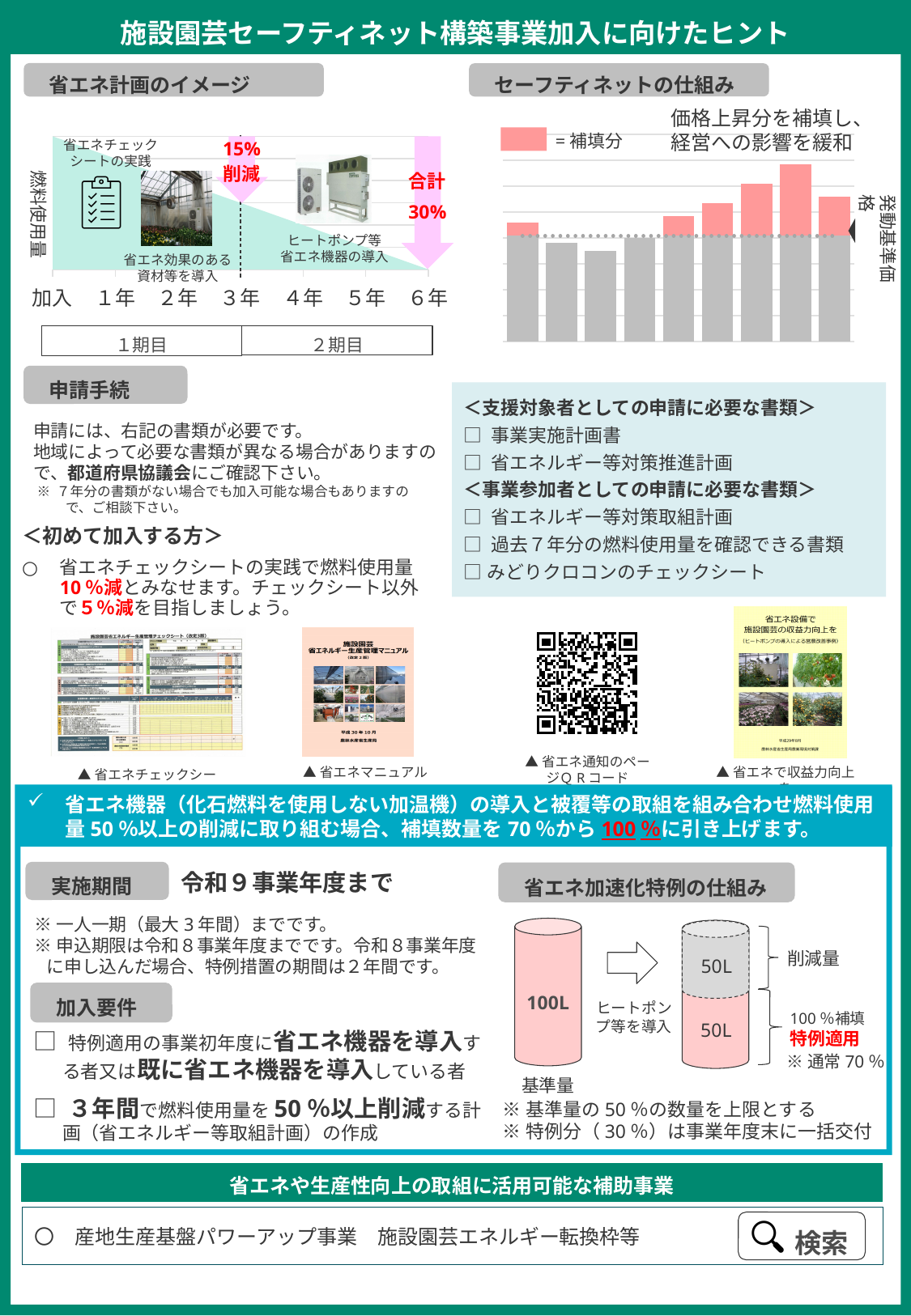
In the セーフティネットの仕組み chart, how many bars are plotted? 9 In the 省エネ計画のイメージ chart, what reduction percentage is marked at 3年? 15%削減 In the 省エネ加速化特例の仕組み diagram, what is the 基準量 shown on the left cylinder? 100L In the セーフティネットの仕組み chart, what does the pink colour represent according to the legend? 補填分 In the 省エネ計画のイメージ chart, how many tick labels are shown along the horizontal axis (from 加入 to 6年)? 7 In the 省エネ計画のイメージ chart, what total reduction is marked at 6年? 合計30% In the セーフティネットの仕組み chart, what is the label on the right-hand axis? 発動基準価格 In the セーフティネットの仕組み chart, how many bars have a pink (補填分) portion above the 発動基準価格 line? 6 In the 省エネ計画のイメージ chart, does fuel usage (燃料使用量) rise or fall from 加入 to 6年? fall In the 省エネ計画のイメージ chart, what is the label on the vertical axis? 燃料使用量 What kind of chart is shown under the heading セーフティネットの仕組み? bar chart In the 省エネ加速化特例の仕組み diagram, what is the 削減量 shown on the right cylinder? 50L